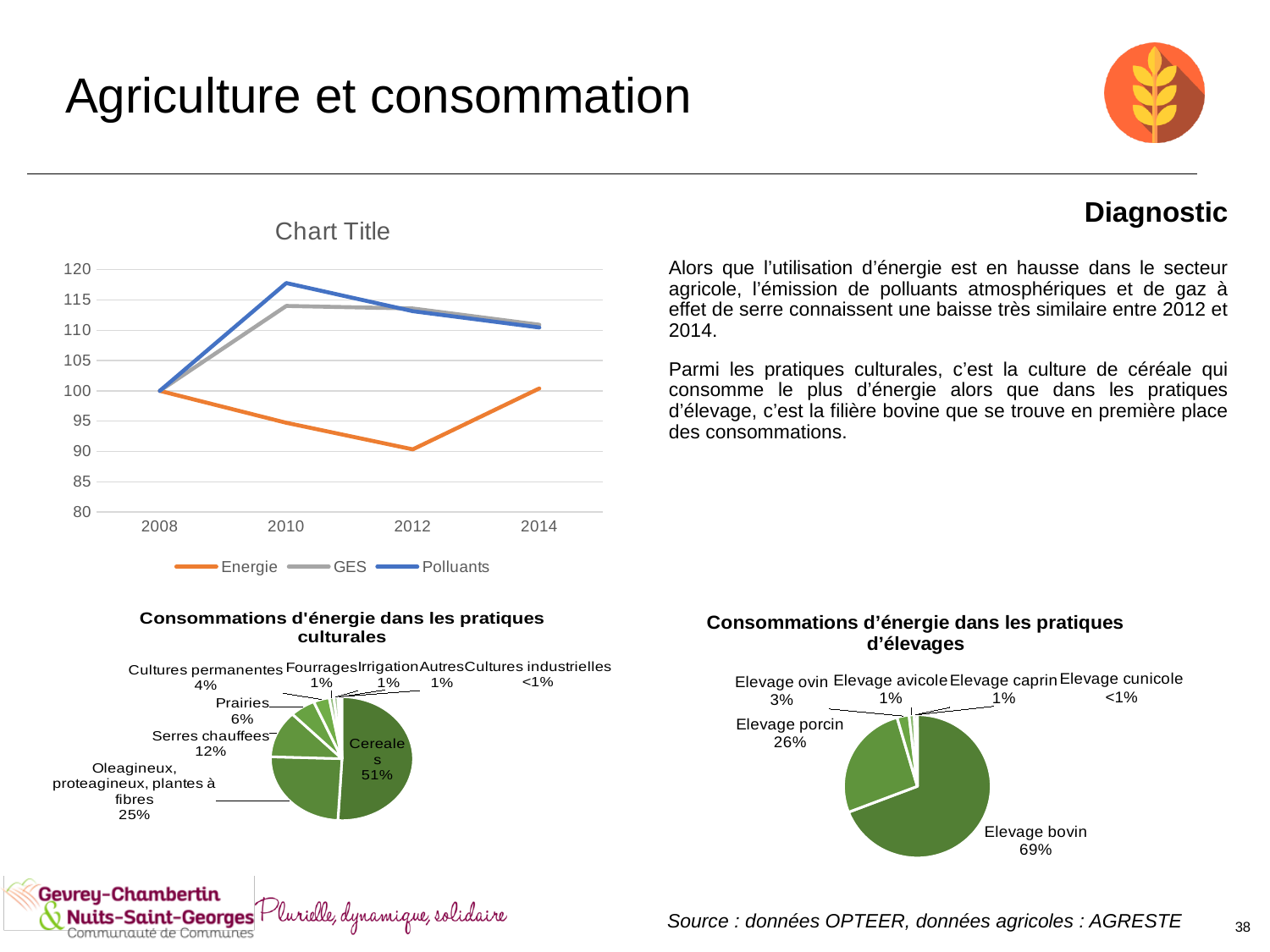
In the pie chart 'Consommations d'énergie dans les pratiques d'élevages', what share does Elevage porcin have? 26% In the line chart titled 'Chart Title', is the value for Polluants in 2010 greater or less than 115? greater In the line chart titled 'Chart Title', how many years are shown on the x axis? 4 In the line chart titled 'Chart Title', is the value for Energie in 2012 greater or less than 95? less In the pie chart 'Consommations d'énergie dans les pratiques d'élevages', which category has the largest share? Elevage bovin In the line chart titled 'Chart Title', what are the names of the series in the legend? Energie, GES, Polluants In the line chart titled 'Chart Title', how many series does the legend list? 3 What kind of chart is 'Consommations d'énergie dans les pratiques d'élevages'? pie chart In the line chart titled 'Chart Title', does the Energie series rise or fall between 2008 and 2012? fall In the pie chart 'Consommations d'énergie dans les pratiques culturales', what share does Cereales have? 51% In the line chart titled 'Chart Title', which series has the lowest value in 2012? Energie In the pie chart 'Consommations d'énergie dans les pratiques culturales', what is the difference between the shares of Oleagineux, proteagineux, plantes à fibres and Serres chauffees? 13%